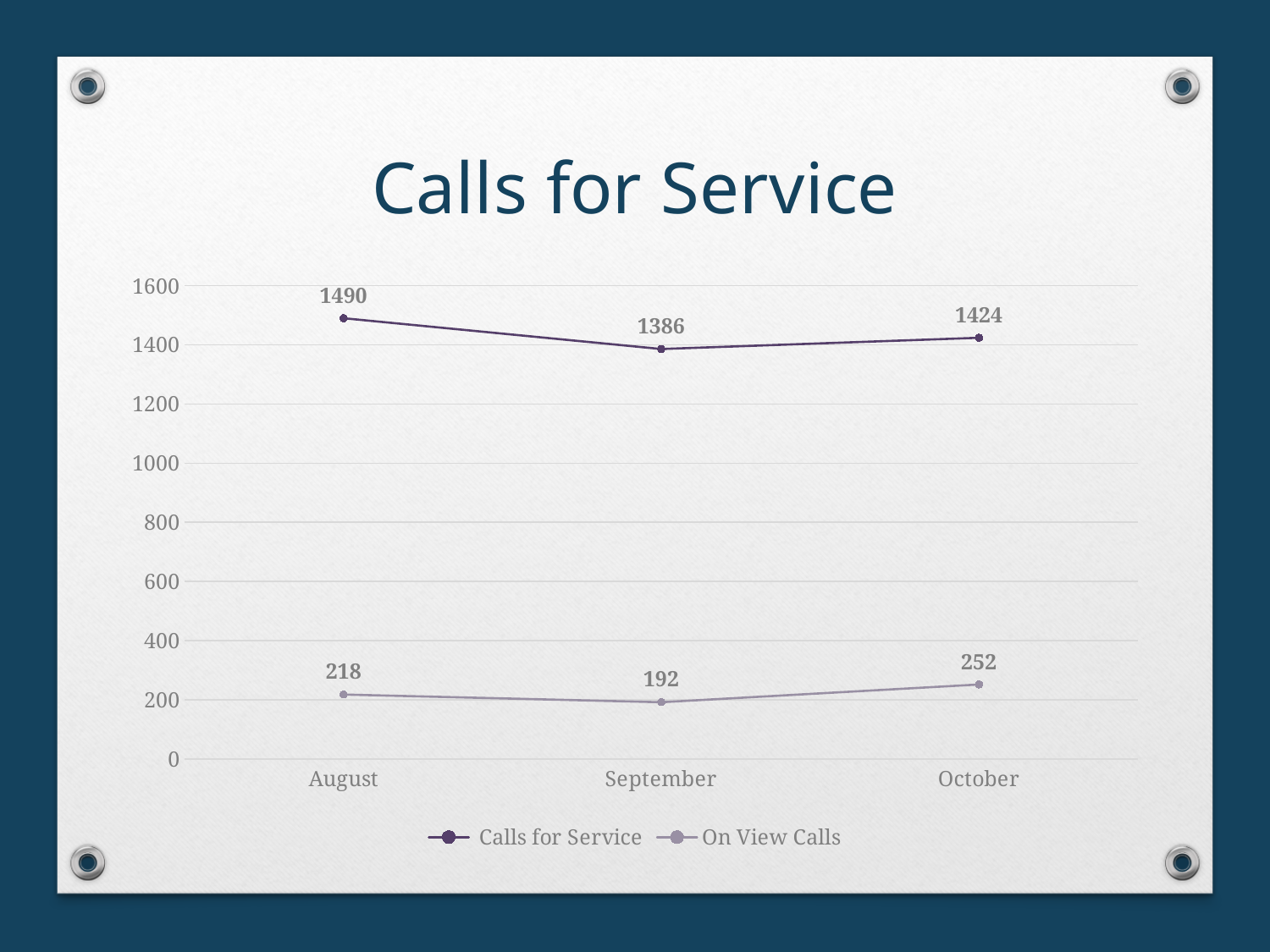
What is the value for Calls for Service in October? 1424 What is the value for On View Calls in September? 192 What kind of chart is shown on the slide? Line chart What is the difference between Calls for Service in August and September? 104 Which month has the lowest value for On View Calls? September Which month has the highest value for Calls for Service? August Which is larger: Calls for Service in September or in October? October What is the difference between On View Calls in October and August? 34 What is the value for Calls for Service in August? 1490 How many series does the legend list? 2 How many months are shown on the x axis? 3 What is the title of the chart? Calls for Service